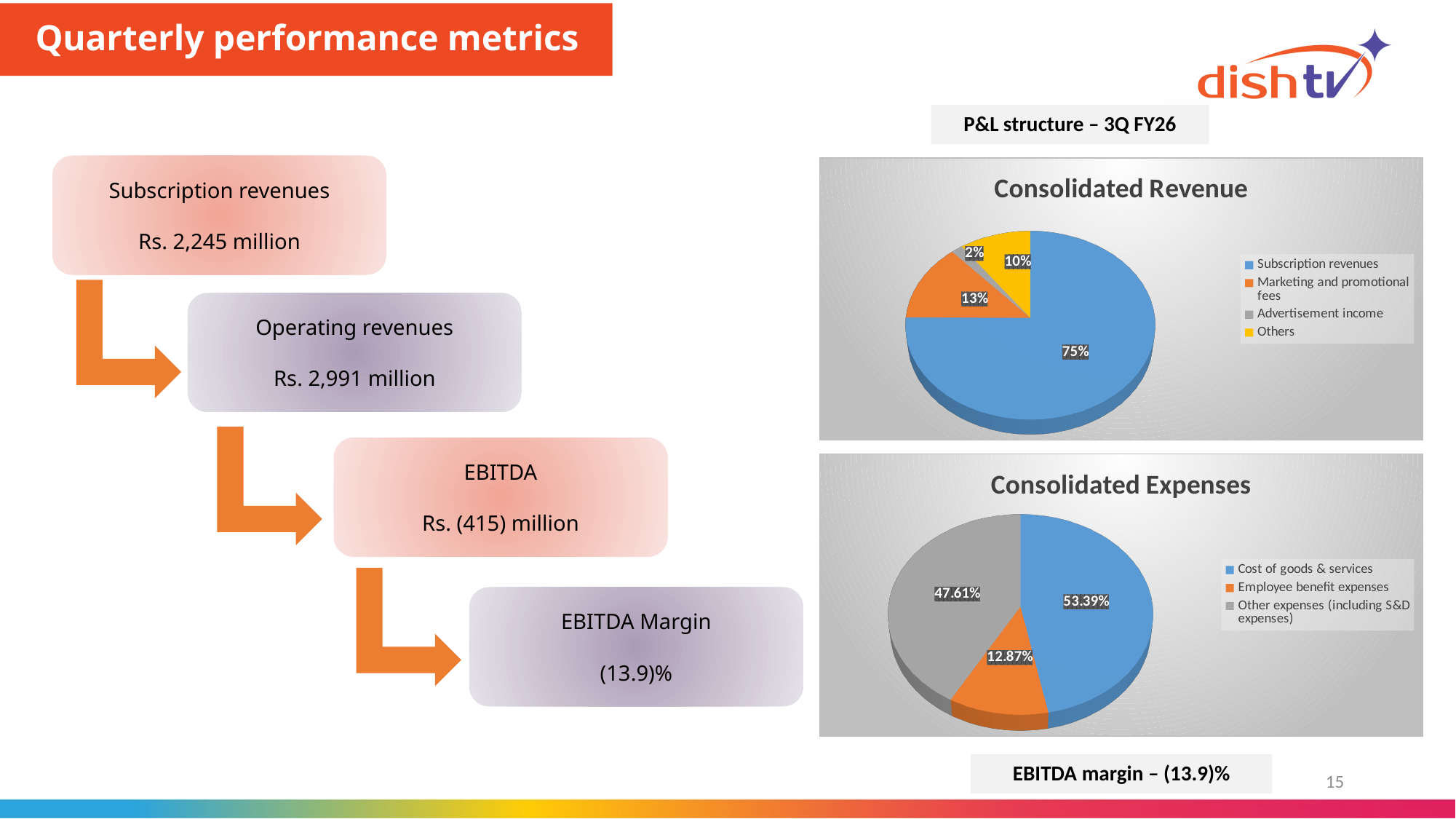
In the Consolidated Revenue chart, what share does Marketing and promotional fees have? 13% In the Consolidated Expenses chart, what is the difference between the Cost of goods & services share and the Other expenses share? 5.78% In the Consolidated Revenue chart, what share does Advertisement income have? 2% In the Consolidated Expenses chart, what share does Employee benefit expenses have? 12.87% In the Consolidated Revenue chart, how many categories does the legend list? 4 In the Consolidated Revenue chart, which category has the smallest share? Advertisement income In the Consolidated Revenue chart, what is the difference between the Others share and the Advertisement income share? 8% In the Consolidated Revenue chart, what share does Subscription revenues have? 75% What type of chart is the Consolidated Expenses chart? Pie chart In the Consolidated Expenses chart, which is larger: Other expenses (including S&D expenses) or Employee benefit expenses? Other expenses (including S&D expenses) In the Consolidated Expenses chart, what share does Cost of goods & services have? 53.39% In the Consolidated Expenses chart, which category has the largest share? Cost of goods & services